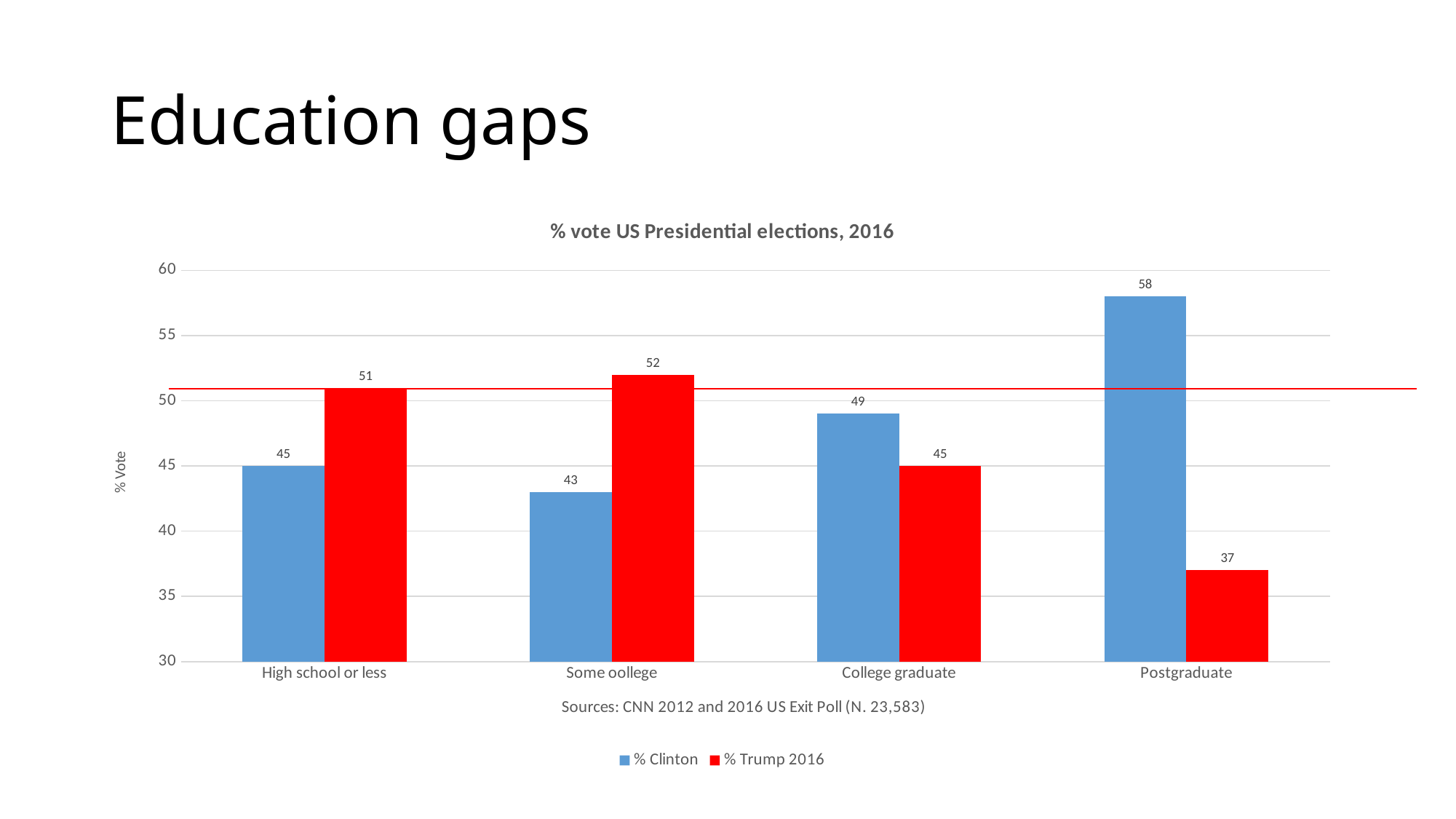
What is the % Clinton value for High school or less? 45 What kind of chart is shown on the slide? Bar chart What is the % Trump 2016 value for Some oollege? 52 What is the title of the chart? % vote US Presidential elections, 2016 For College graduate, which is larger: % Clinton or % Trump 2016? % Clinton How many education categories are shown on the x axis? 4 Which category has the lowest % Trump 2016 value? Postgraduate How many series does the legend list? 2 What is the % Trump 2016 value for Postgraduate? 37 What is the difference between % Clinton and % Trump 2016 for Postgraduate? 21 Which category has the highest % Clinton value? Postgraduate What is the % Clinton value for Postgraduate? 58